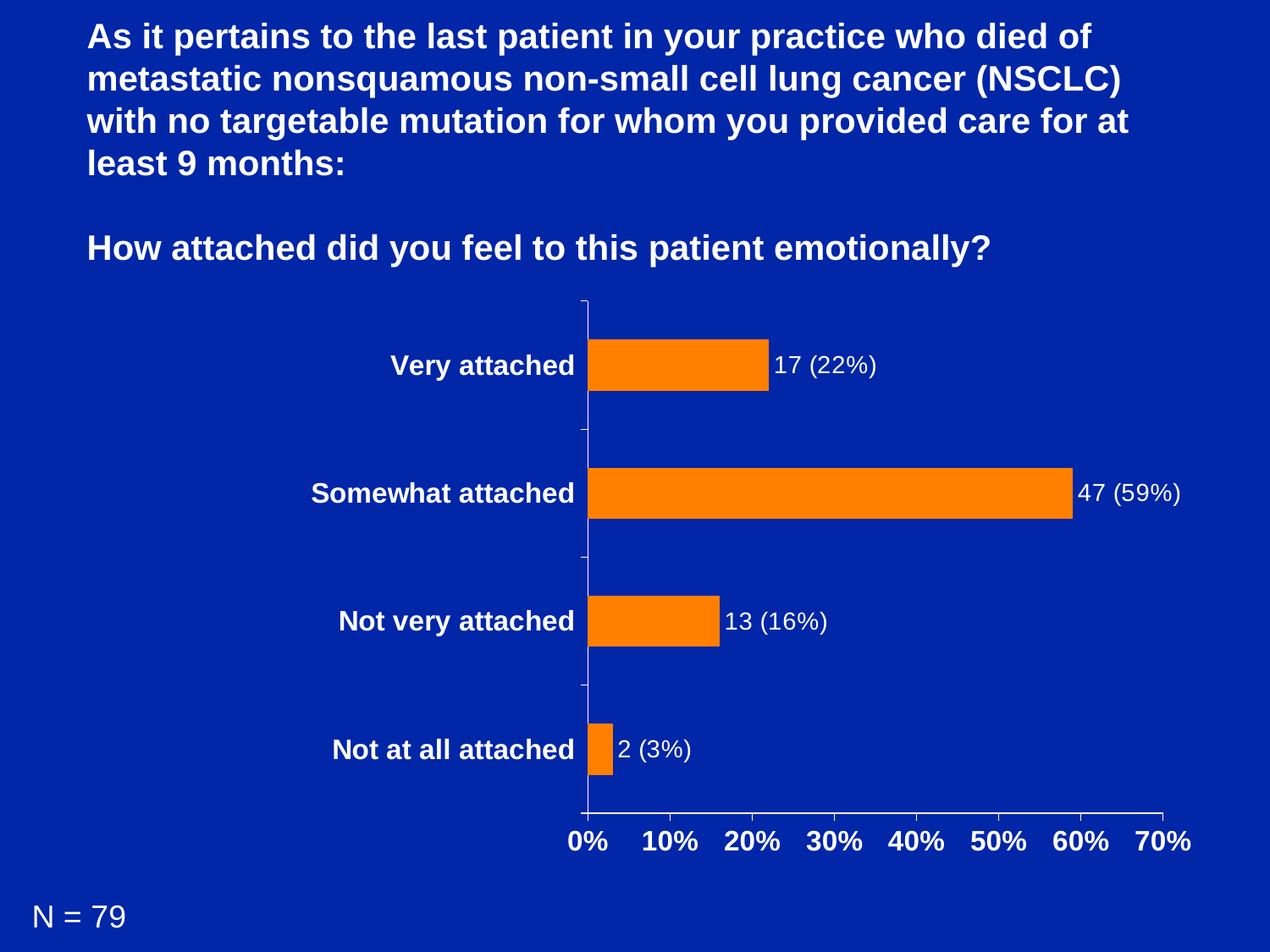
Which category has the lowest value? Not at all attached What is the data label for 'Very attached'? 17 (22%) Is the value for 'Somewhat attached' greater or less than 50%? greater What is the difference in percentage points between 'Somewhat attached' and 'Very attached'? 37% What is the data label for 'Somewhat attached'? 47 (59%) What is the data label for 'Not at all attached'? 2 (3%) What is the data label for 'Not very attached'? 13 (16%) What kind of chart is shown on the slide? Bar chart How many more respondents chose 'Very attached' than 'Not very attached'? 4 Which is larger, the value for 'Very attached' or 'Not very attached'? Very attached Which category has the highest value? Somewhat attached How many categories are shown in the chart? 4